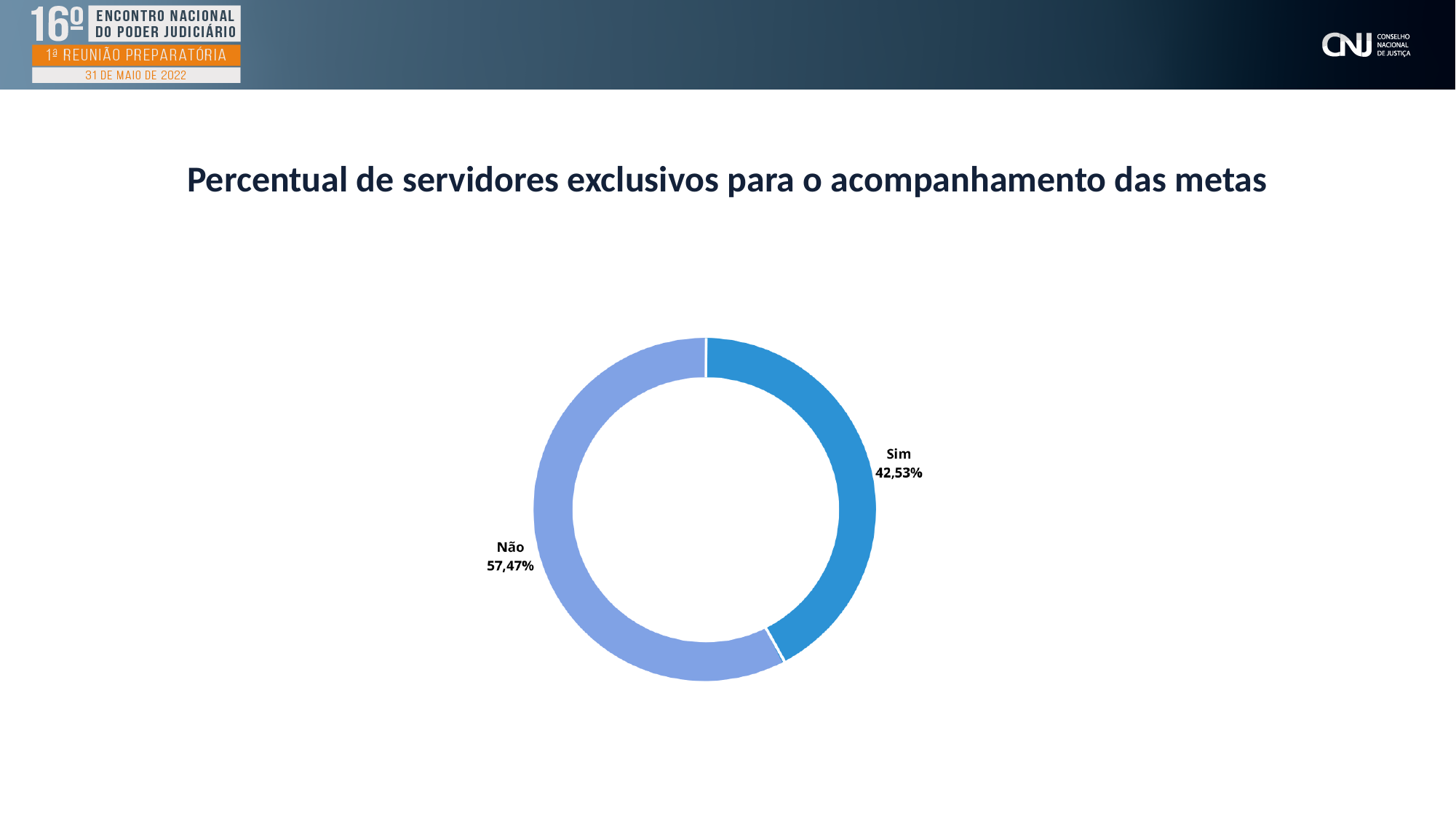
What percentage is shown for the "Não" slice? 57,47% What share of the whole does the "Sim" slice represent? 42,53% Which slice is the largest? Não Which is larger, the "Sim" slice or the "Não" slice? Não Which slice is drawn in the darker blue colour? Sim What percentage is shown for the "Sim" slice? 42,53% What is the title of the chart? Percentual de servidores exclusivos para o acompanhamento das metas Which slice is the smallest? Sim What is the difference in percentage points between the "Não" and "Sim" slices? 14,94 What kind of chart is shown on the slide? Doughnut chart How many slices does the chart have? 2